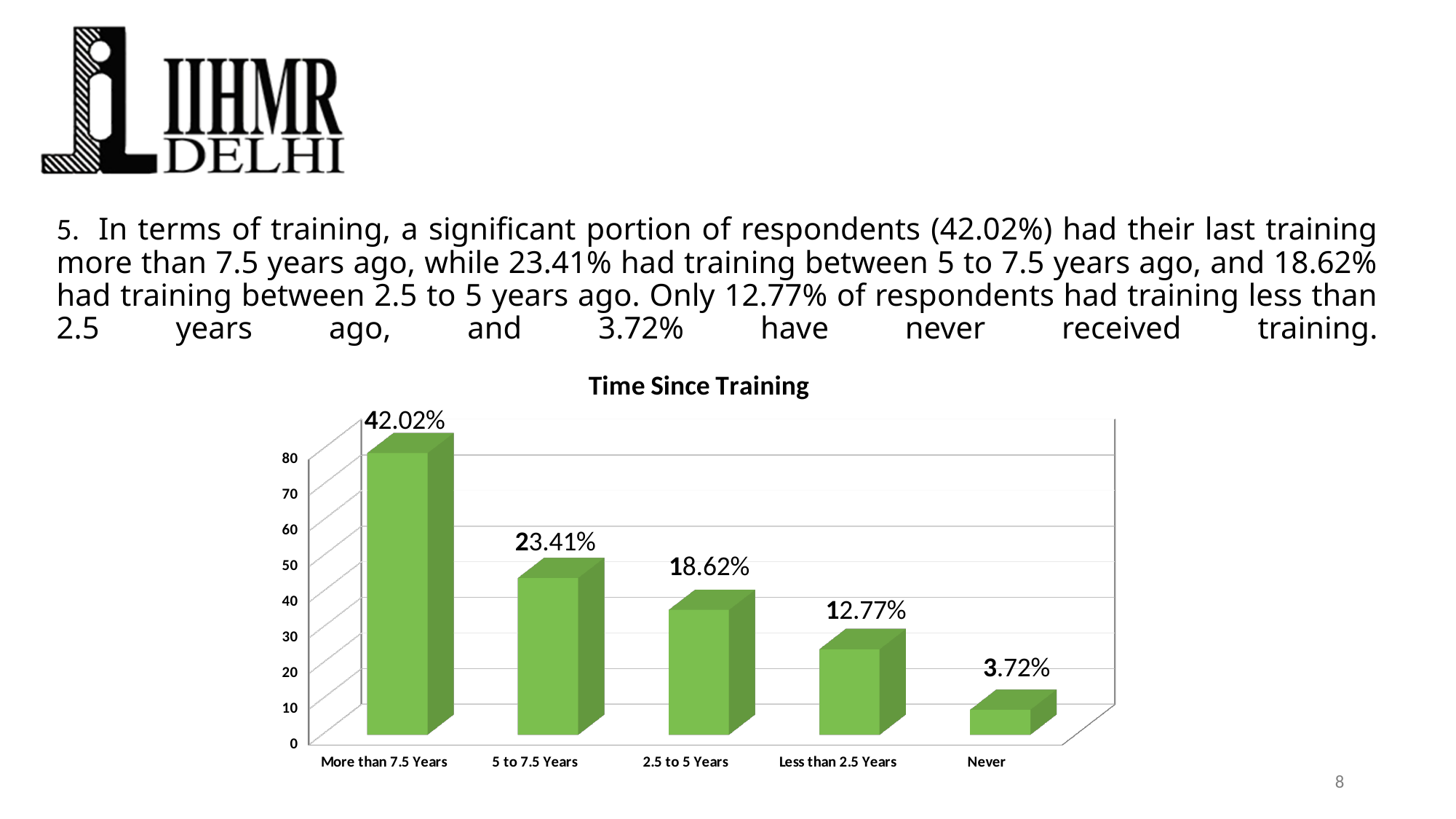
What is the value for 'Less than 2.5 Years' in the Time Since Training chart? 12.77% What is the value for 'More than 7.5 Years' in the Time Since Training chart? 42.02% Which is larger in the Time Since Training chart: '2.5 to 5 Years' or 'Less than 2.5 Years'? 2.5 to 5 Years Which category has the highest value in the Time Since Training chart? More than 7.5 Years Which category has the lowest value in the Time Since Training chart? Never What is the value for '5 to 7.5 Years' in the Time Since Training chart? 23.41% How many categories are shown in the Time Since Training chart? 5 What is the value for 'Never' in the Time Since Training chart? 3.72% What kind of chart is the Time Since Training chart? Bar chart What is the value for '2.5 to 5 Years' in the Time Since Training chart? 18.62% What is the difference between the values for 'Less than 2.5 Years' and 'Never' in the Time Since Training chart? 9.05% What is the difference between the values for 'More than 7.5 Years' and '5 to 7.5 Years' in the Time Since Training chart? 18.61%